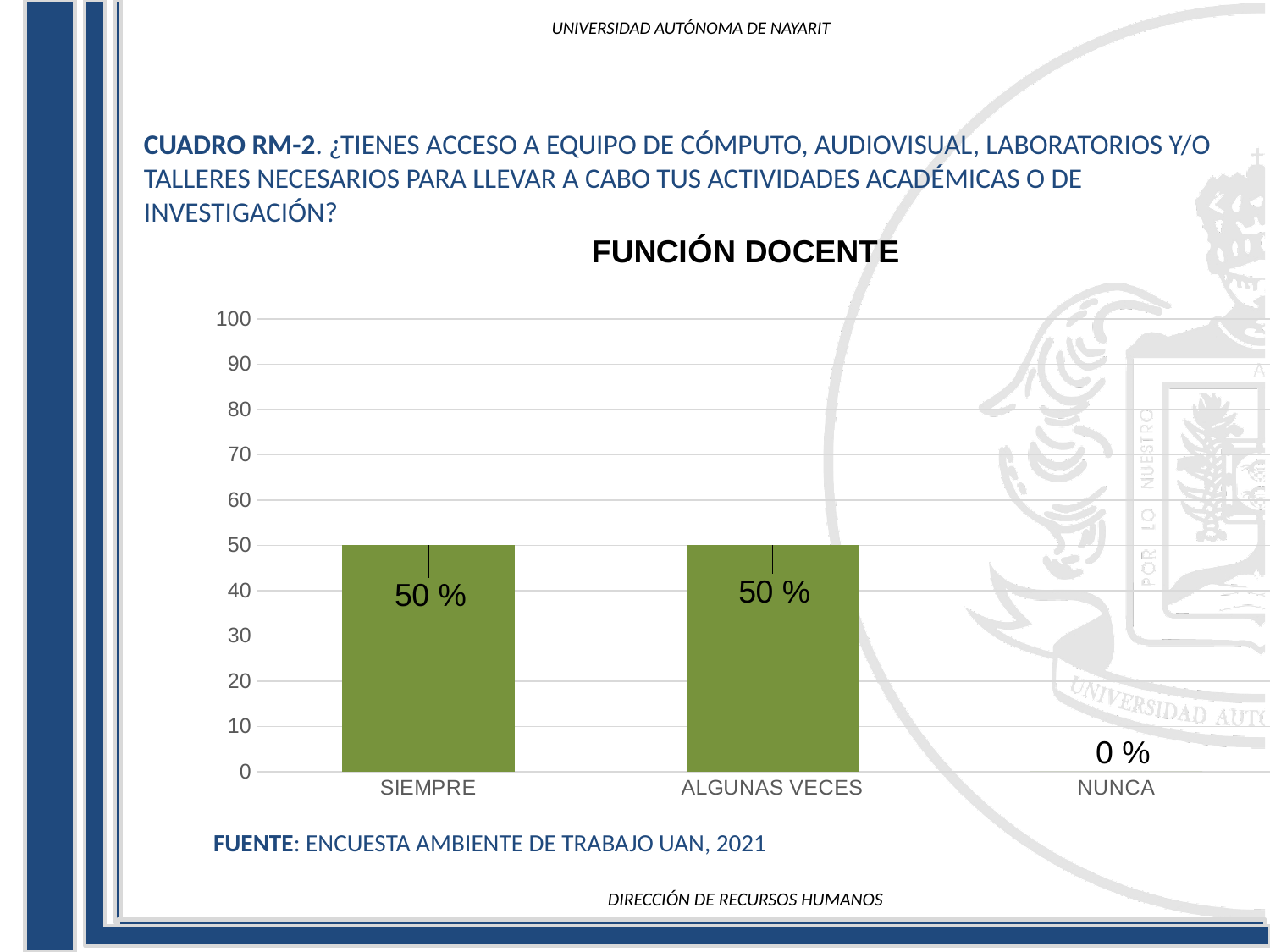
What is the value for ALGUNAS VECES? 50 % What is the value for SIEMPRE? 50 % What is the highest value shown on the y axis? 100 Which is larger, the value for ALGUNAS VECES or the value for NUNCA? ALGUNAS VECES Which category has the lowest value? NUNCA What is the title of the chart? FUNCIÓN DOCENTE How many categories are shown on the x axis? 3 Do the values rise or fall from ALGUNAS VECES to NUNCA? fall Is the value for SIEMPRE greater or less than 80? less What is the value for NUNCA? 0 % What is the difference between the values for SIEMPRE and NUNCA? 50 % What kind of chart is shown? bar chart